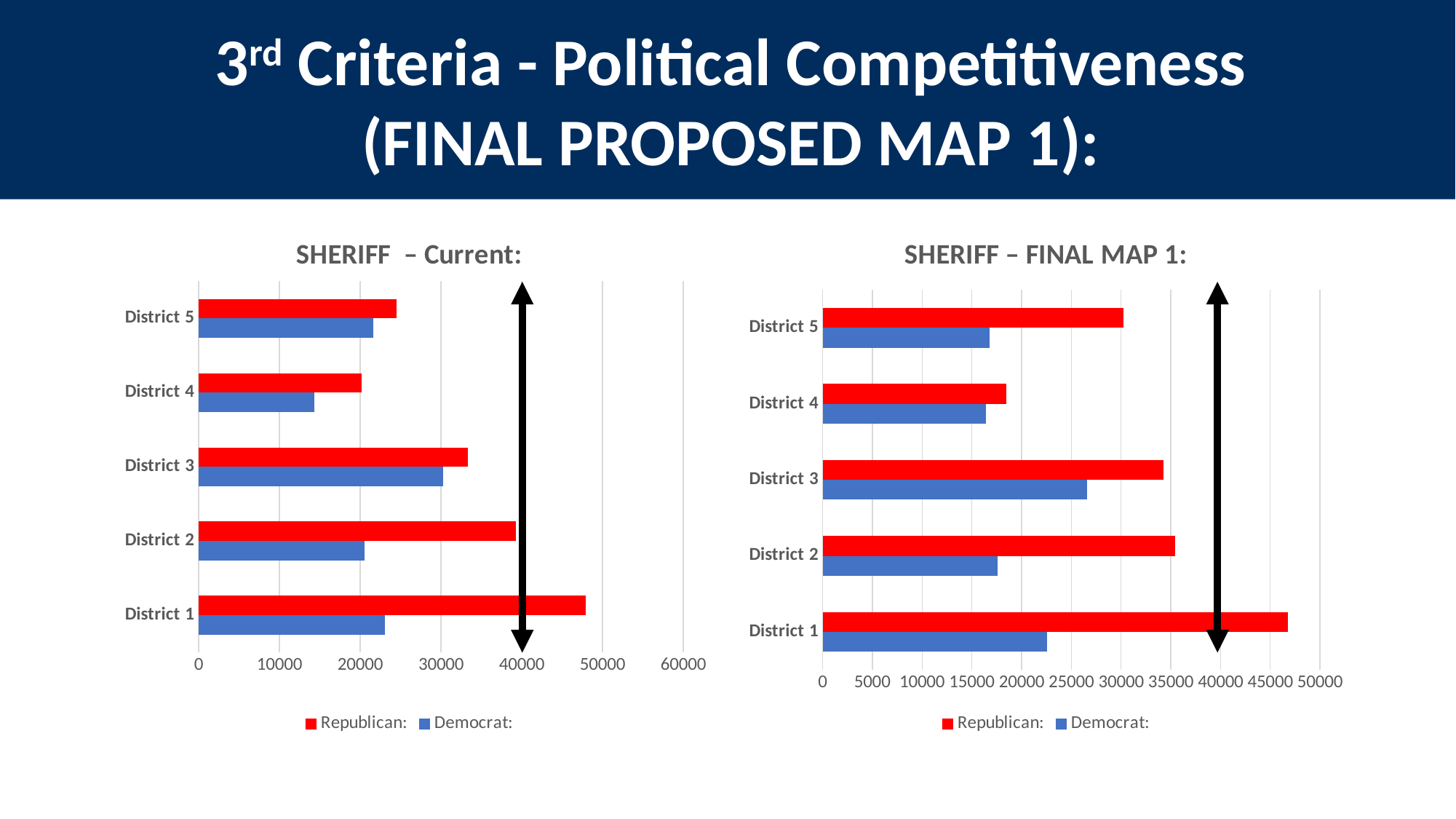
How many series does the legend of the SHERIFF – FINAL MAP 1 chart list? 2 What kind of chart is the SHERIFF – Current chart? bar chart In the SHERIFF – Current chart, is the Republican value for District 1 greater or less than 40000? greater In the SHERIFF – Current chart, which district has the highest Republican value? District 1 In the SHERIFF – FINAL MAP 1 chart, is the Democrat value for District 3 greater or less than 25000? greater In the SHERIFF – Current chart, which district has the lowest Democrat value? District 4 How many districts are shown in the SHERIFF – Current chart? 5 In the SHERIFF – FINAL MAP 1 chart, which district has the highest Republican value? District 1 In the SHERIFF – FINAL MAP 1 chart, what colour represents the Republican series? red In the SHERIFF – Current chart, is the Democrat value for District 4 greater or less than 20000? less In the SHERIFF – FINAL MAP 1 chart, which is larger for District 2, the Republican value or the Democrat value? Republican